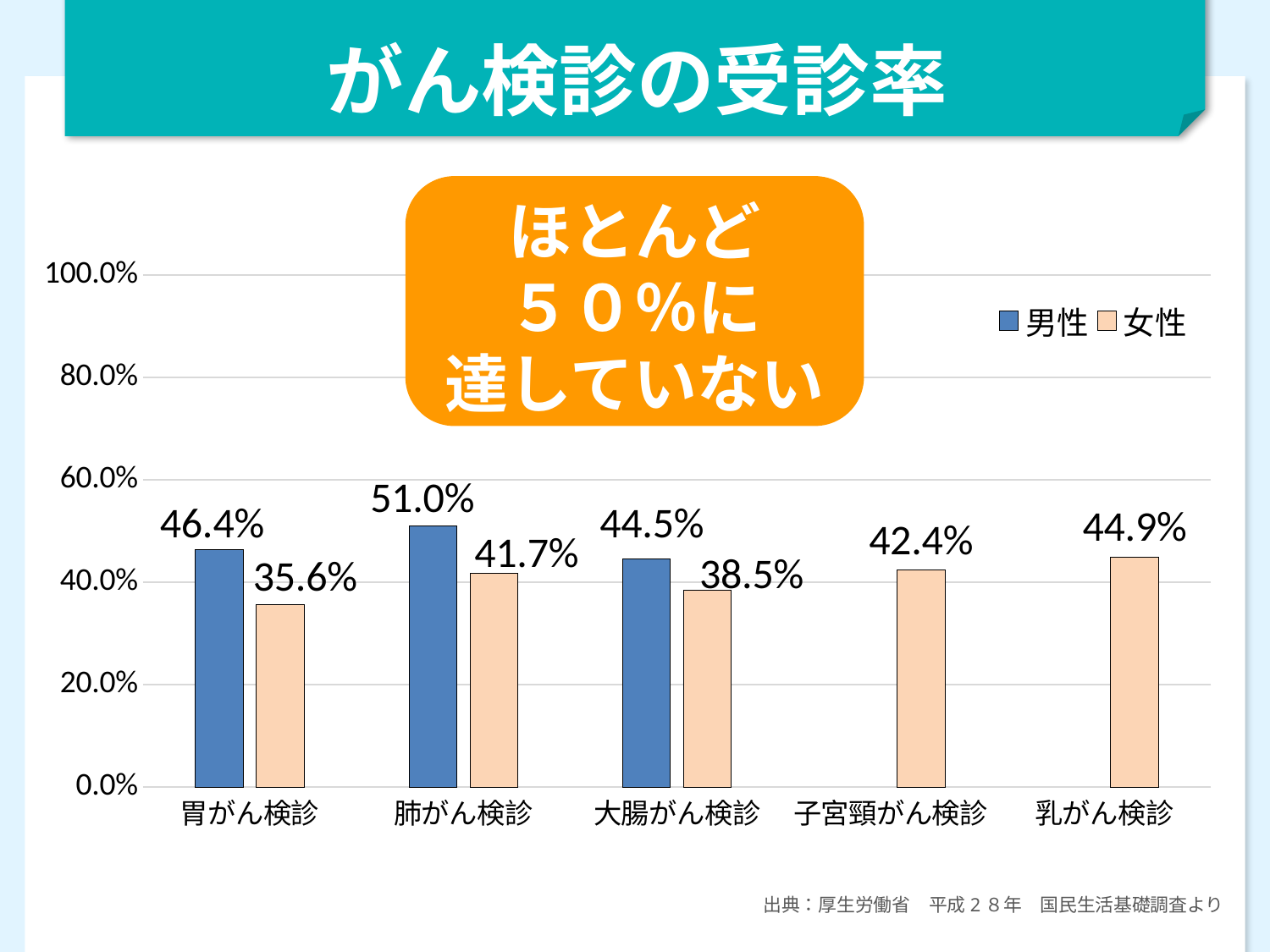
Which category has the highest value for 男性? 肺がん検診 How many series does the legend list? 2 What kind of chart is shown on the slide? bar chart What is the value for 女性 in the 肺がん検診 category? 41.7% How many categories are shown on the x axis? 5 Which category has the lowest value for 女性? 胃がん検診 Is the value for 男性 in 肺がん検診 greater or less than 40.0%? greater What is the value for 男性 in the 胃がん検診 category? 46.4% What is the value for 女性 in the 乳がん検診 category? 44.9% What is the value for 女性 in the 子宮頸がん検診 category? 42.4% Which is larger for 大腸がん検診, the 男性 value or the 女性 value? 男性 What is the difference between the 男性 and 女性 values for 胃がん検診? 10.8%